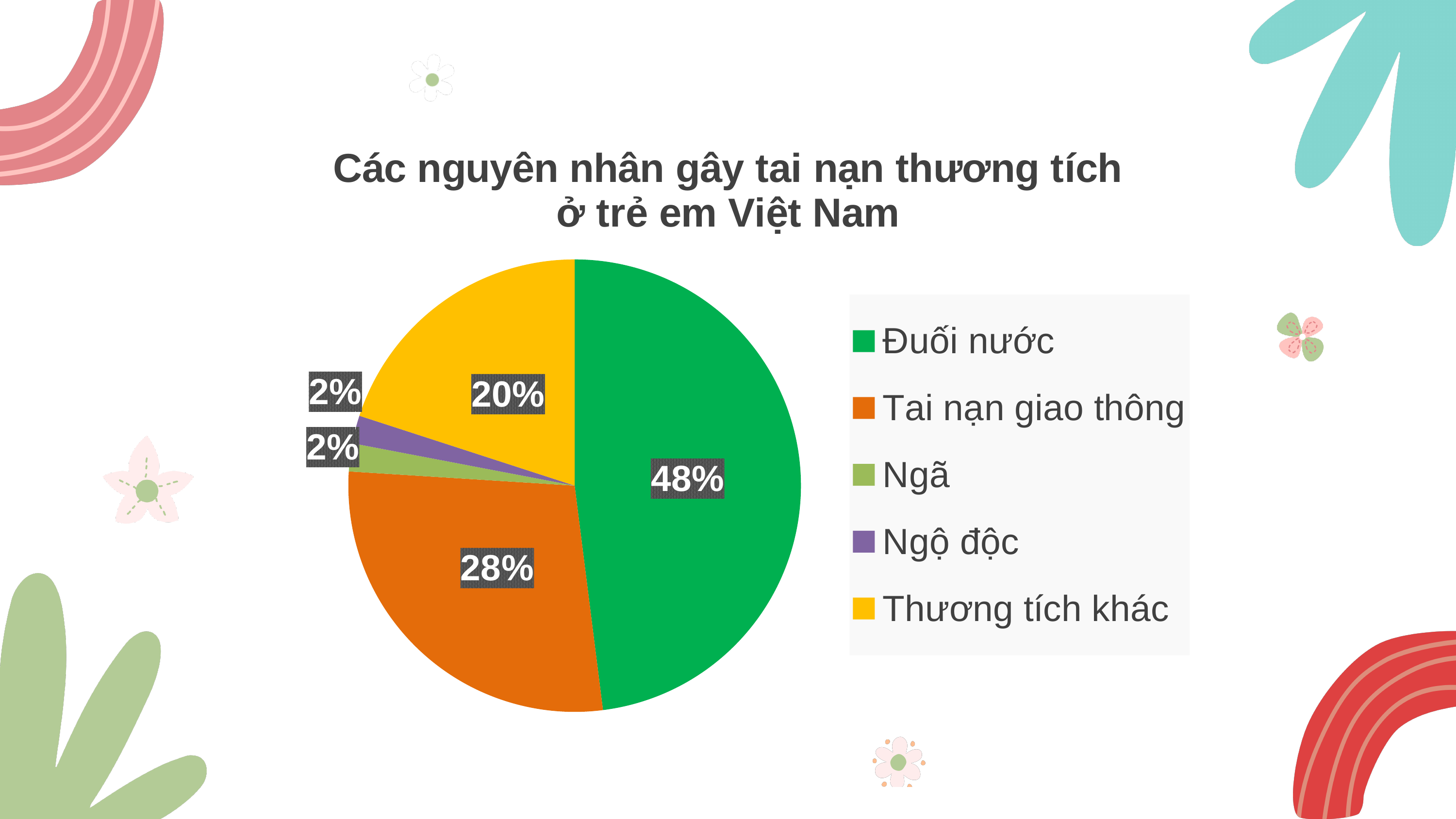
What percentage of the pie is Đuối nước? 48% What percentage of the pie is Thương tích khác? 20% What is the difference between the shares of Đuối nước and Tai nạn giao thông? 20% What is the title of the chart? Các nguyên nhân gây tai nạn thương tích ở trẻ em Việt Nam Which is larger, the share of Tai nạn giao thông or the share of Thương tích khác? Tai nạn giao thông What percentage of the pie is Ngộ độc? 2% What kind of chart is shown on the slide? Pie chart What colour is the slice for Thương tích khác? Yellow Which category has the largest share of the pie? Đuối nước What percentage of the pie is Ngã? 2% What percentage of the pie is Tai nạn giao thông? 28% How many categories does the legend list? 5